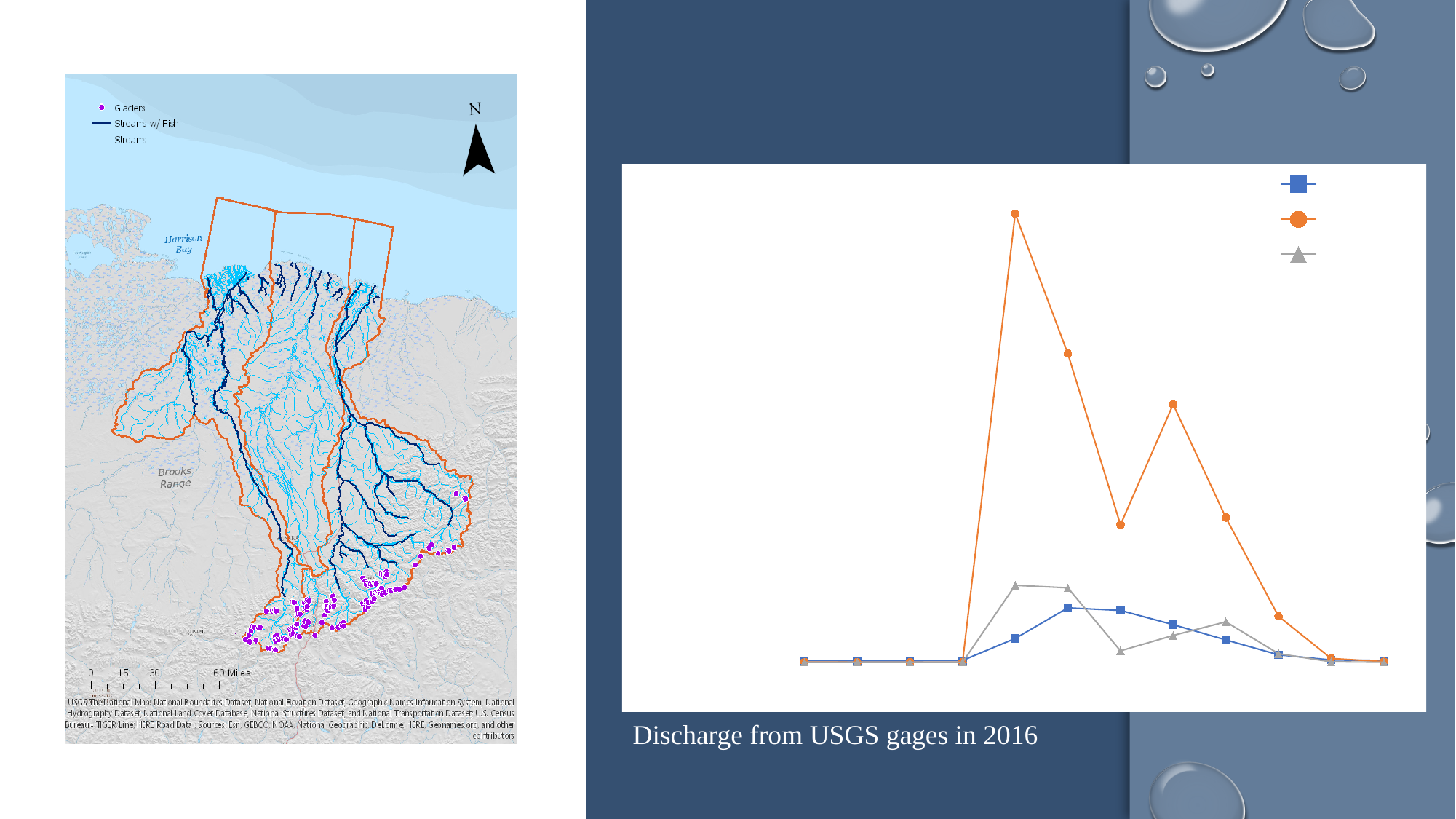
What caption is written below the line chart? Discharge from USGS gages in 2016 What marker shapes are used for the three series in the line chart? square, circle, triangle Which series in the line chart has the lowest peak value? the blue series (square markers) How many series does the legend of the line chart list? 3 How many data points does each series in the line chart have? 12 At the point where the orange series peaks, which series has the lowest value? the blue series (square markers) Which series in the line chart reaches the highest value? the orange series (circle markers) What kind of chart is shown on the right side of the slide? line chart Does the orange series rise or fall between its highest point and the next point along the x axis? fall